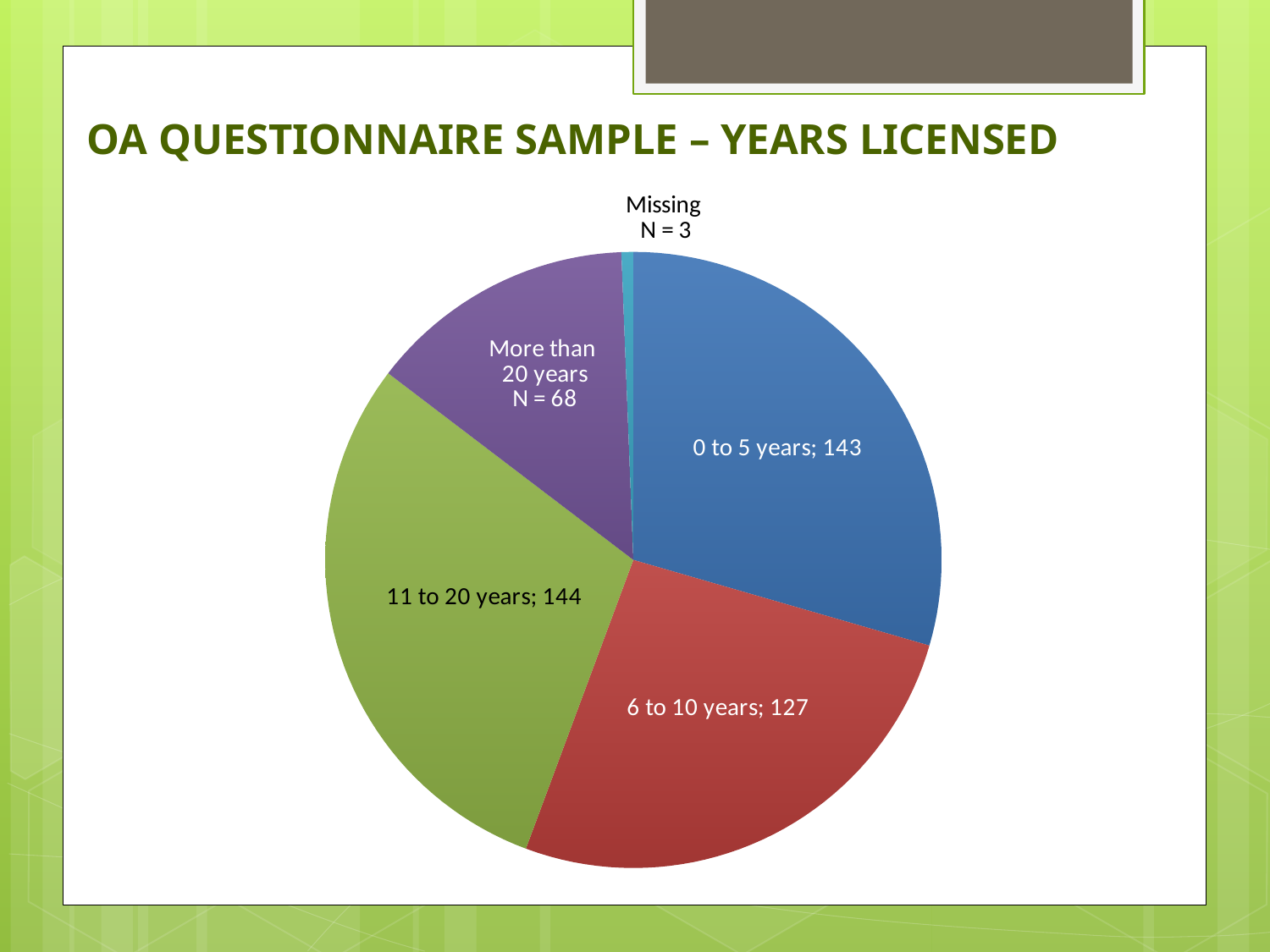
What is N for the More than 20 years category? 68 How many respondents are in the 0 to 5 years category? 143 Which category has the smallest slice of the pie? Missing What is the title of the chart on the slide? OA QUESTIONNAIRE SAMPLE – YEARS LICENSED How many categories (slices) does the pie chart have? 5 What is the difference between the 11 to 20 years value and the More than 20 years value? 76 How many responses are labelled Missing? 3 What type of chart is shown on the slide? Pie chart What is the difference between the 0 to 5 years value and the 6 to 10 years value? 16 What is the value for the 11 to 20 years slice? 144 Which is larger, the 0 to 5 years slice or the 6 to 10 years slice? 0 to 5 years What is the value for the 6 to 10 years slice? 127